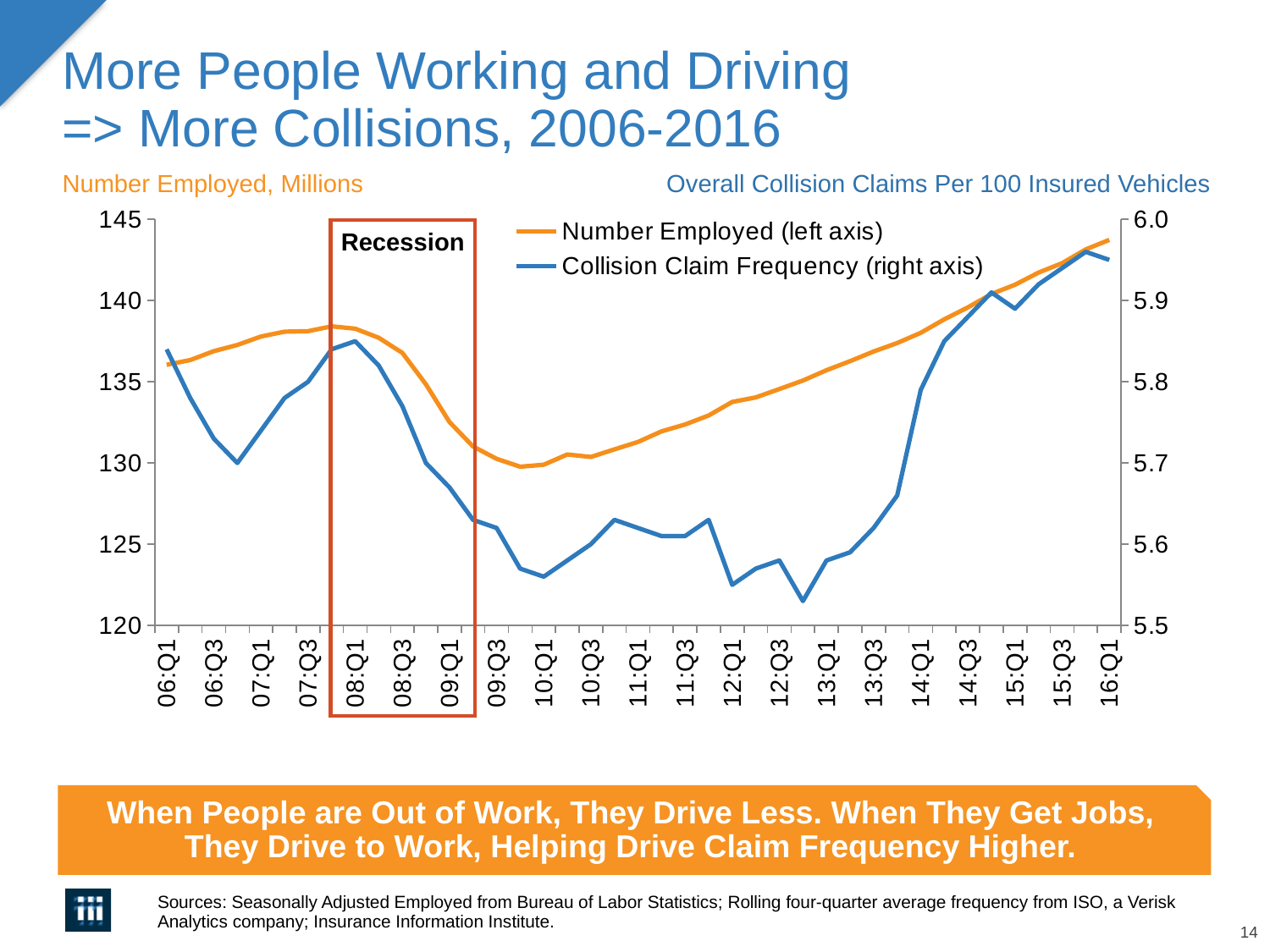
What period is marked by the red box on the chart? Recession Does Number Employed rise or fall from 10:Q1 to 16:Q1? rise Is the value for Number Employed at 08:Q1 greater or less than 135? greater Does Number Employed rise or fall from 08:Q1 to 10:Q1? fall Which series is plotted against the right axis? Collision Claim Frequency How many series does the legend list? 2 Is the value for Collision Claim Frequency at 08:Q1 greater or less than 5.8? greater What kind of chart is shown on the slide? Line chart Is the value for Collision Claim Frequency at 10:Q1 greater or less than 5.6? less Which is larger, Collision Claim Frequency at 08:Q1 or at 10:Q1? 08:Q1